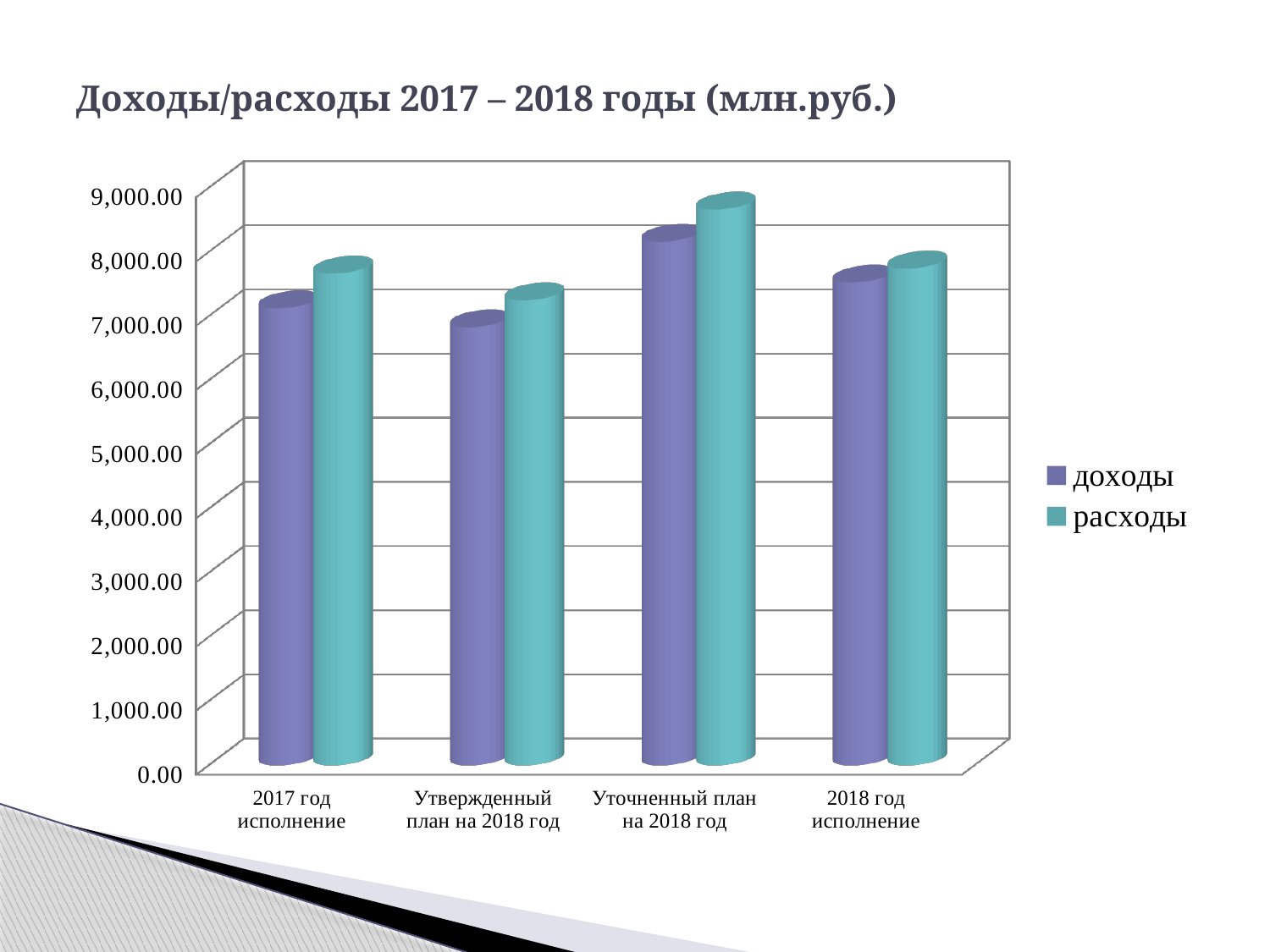
How many series does the legend list? 2 What kind of chart is shown on the slide? bar chart Is the value for расходы in 2017 год исполнение greater or less than 8,000.00? less Which category has the highest value for доходы? Уточненный план на 2018 год How many categories are shown on the x axis? 4 Which category has the lowest value for расходы? Утвержденный план на 2018 год What is the title of the chart? Доходы/расходы 2017 – 2018 годы (млн.руб.) Is the value for доходы in Утвержденный план на 2018 год greater or less than 8,000.00? less For 2017 год исполнение, which is larger: доходы or расходы? расходы Which category has the highest value for расходы? Уточненный план на 2018 год Which category has the lowest value for доходы? Утвержденный план на 2018 год Is the value for расходы in Уточненный план на 2018 год greater or less than 8,000.00? greater